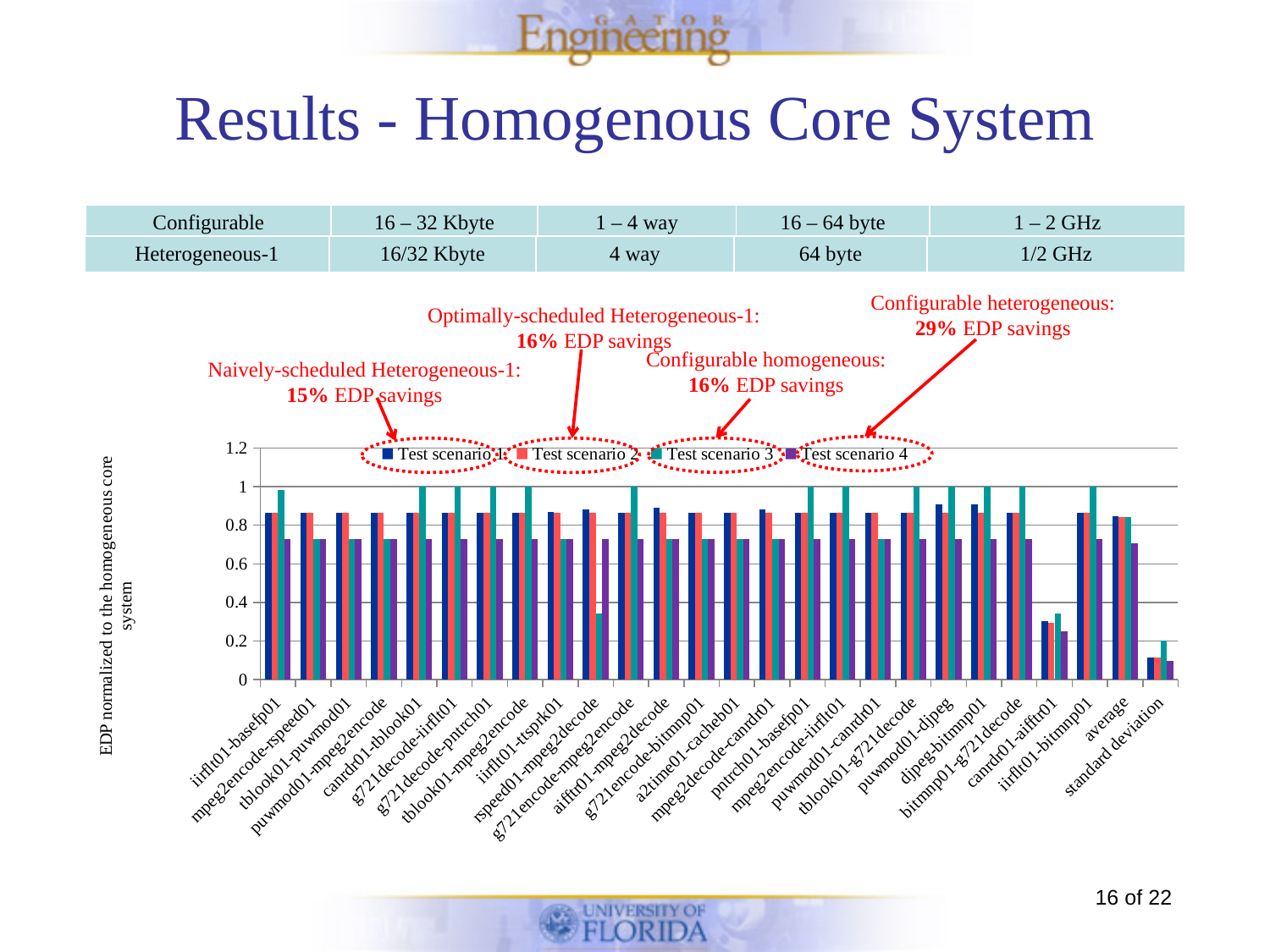
What are the legend entries of the chart? Test scenario 1, Test scenario 2, Test scenario 3, Test scenario 4 Which category has the lowest Test scenario 1 value? standard deviation What is the y-axis label of the chart? EDP normalized to the homogeneous core system Is the Test scenario 3 value for canrdr01-aifftr01 greater or less than 0.4? less What is the highest tick value shown on the y axis of the chart? 1.2 Is the Test scenario 4 value for iirflt01-basefp01 greater or less than 0.8? less What kind of chart is shown on the slide? bar chart For iirflt01-basefp01, which is larger: the Test scenario 3 value or the Test scenario 4 value? Test scenario 3 Is the Test scenario 1 value for standard deviation greater or less than 0.2? less How many series does the chart's legend list? 4